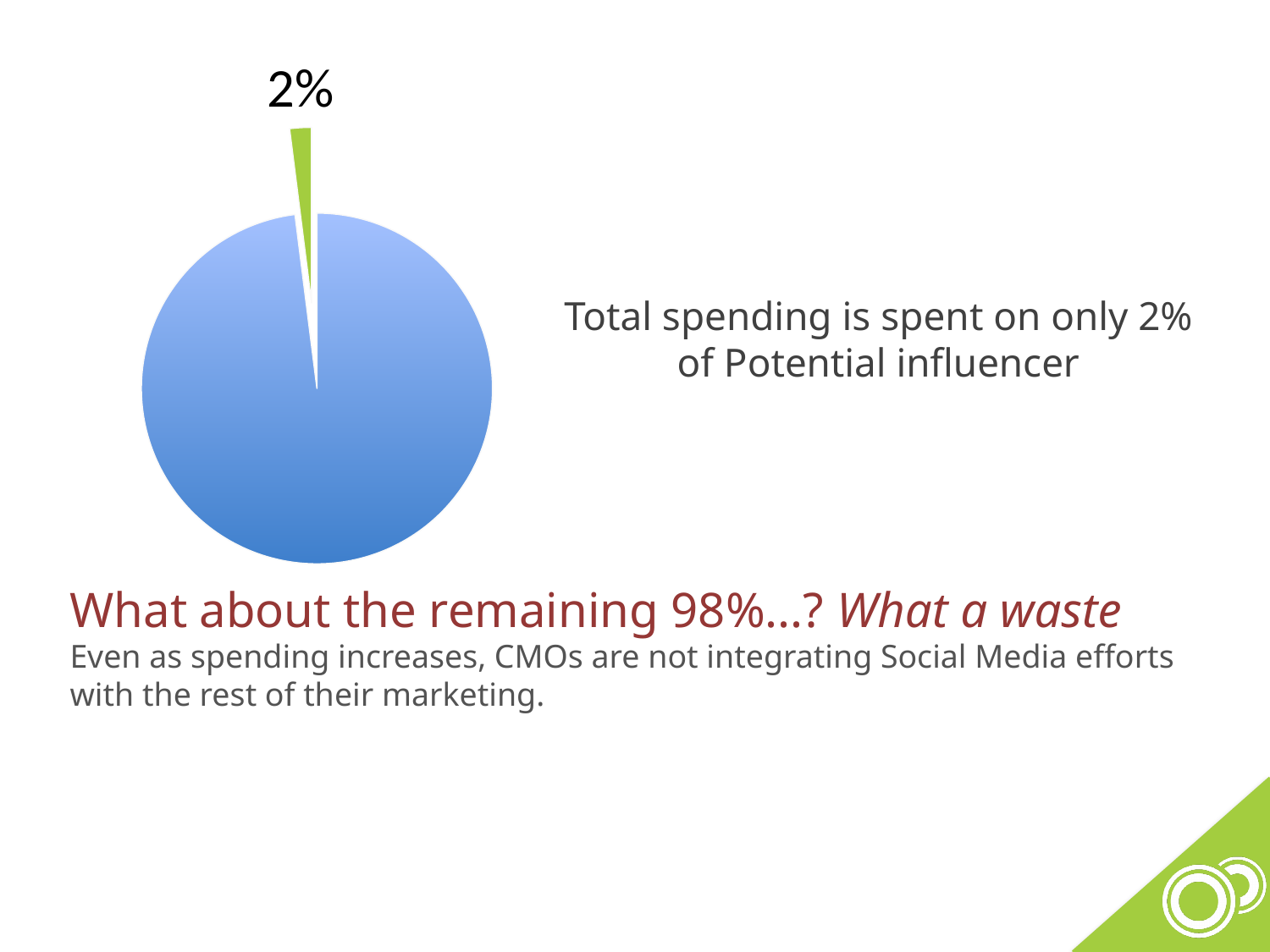
Which slice of the pie chart is larger, the blue slice or the green slice? the blue slice Does the pie chart display a legend? No What colour is the slice labelled 2% in the pie chart? green What kind of chart is shown on the slide? pie chart Which slice of the pie chart is the smallest? the green slice What percentage is shown on the data label of the small green slice of the pie chart? 2% What share of the pie does the small exploded slice represent? 2% How many slices does the pie chart have? 2 What share of the pie does the large blue slice represent? 98%